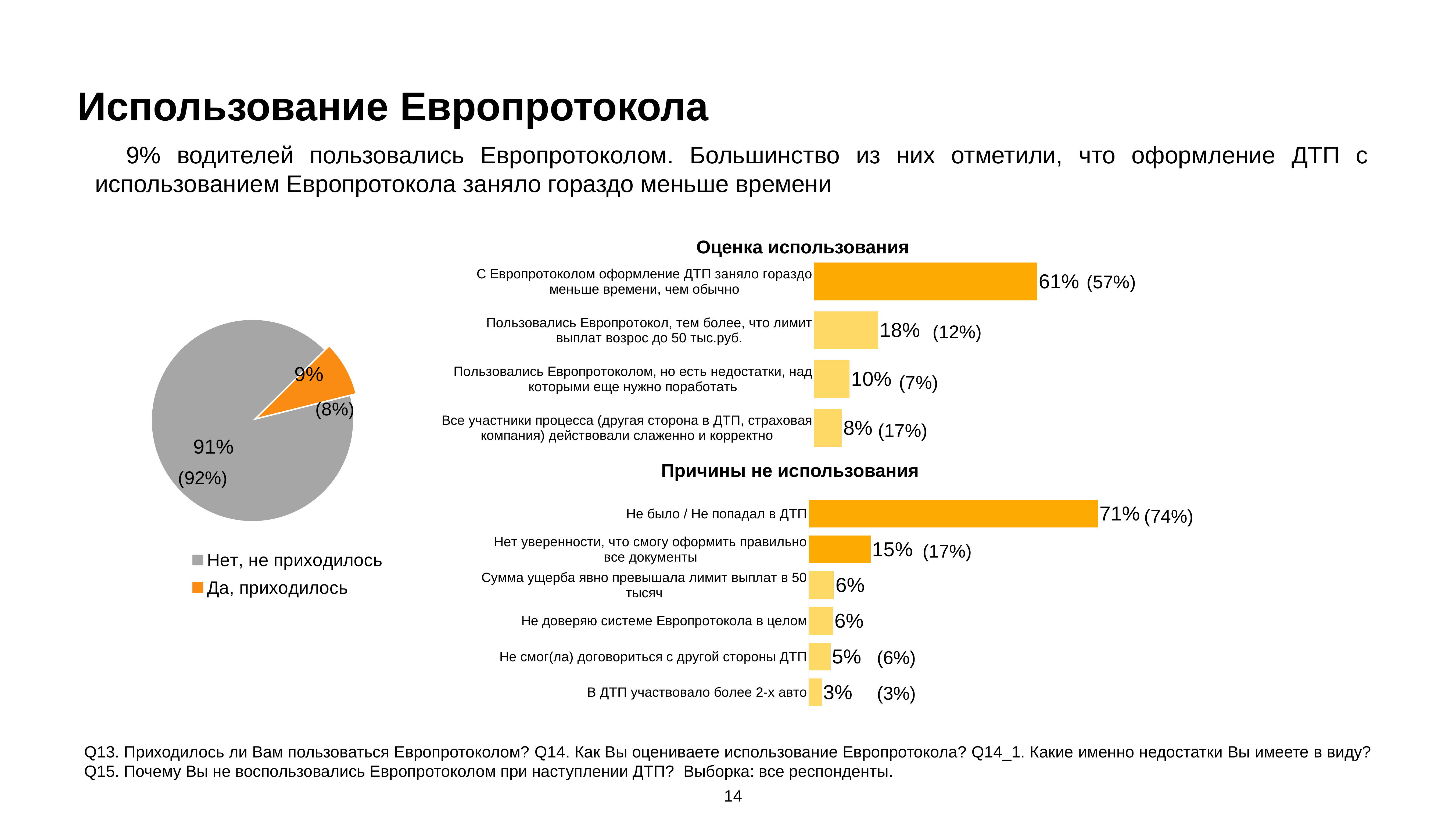
What type of chart is "Причины не использования"? Bar chart In the "Оценка использования" chart, which category has the lowest value? Все участники процесса (другая сторона в ДТП, страховая компания) действовали слаженно и корректно In the "Оценка использования" chart, what is the difference between the values for "Пользовались Европротокол, тем более, что лимит выплат возрос до 50 тыс.руб." and "Пользовались Европротоколом, но есть недостатки, над которыми еще нужно поработать"? 8% In the pie chart on the left, what share of respondents answered "Да, приходилось"? 9% In the "Оценка использования" chart, how many categories are shown? 4 In the pie chart on the left, what share of respondents answered "Нет, не приходилось"? 91% In the "Причины не использования" chart, which category has the highest value? Не было / Не попадал в ДТП In the "Причины не использования" chart, how many categories are shown? 6 In the "Оценка использования" chart, what is the value for "С Европротоколом оформление ДТП заняло гораздо меньше времени, чем обычно"? 61% In the "Причины не использования" chart, what is the value for "Нет уверенности, что смогу оформить правильно все документы"? 15% In the "Причины не использования" chart, which is larger: the value for "Не смог(ла) договориться с другой стороны ДТП" or for "В ДТП участвовало более 2-х авто"? Не смог(ла) договориться с другой стороны ДТП How many entries does the legend of the pie chart on the left list? 2